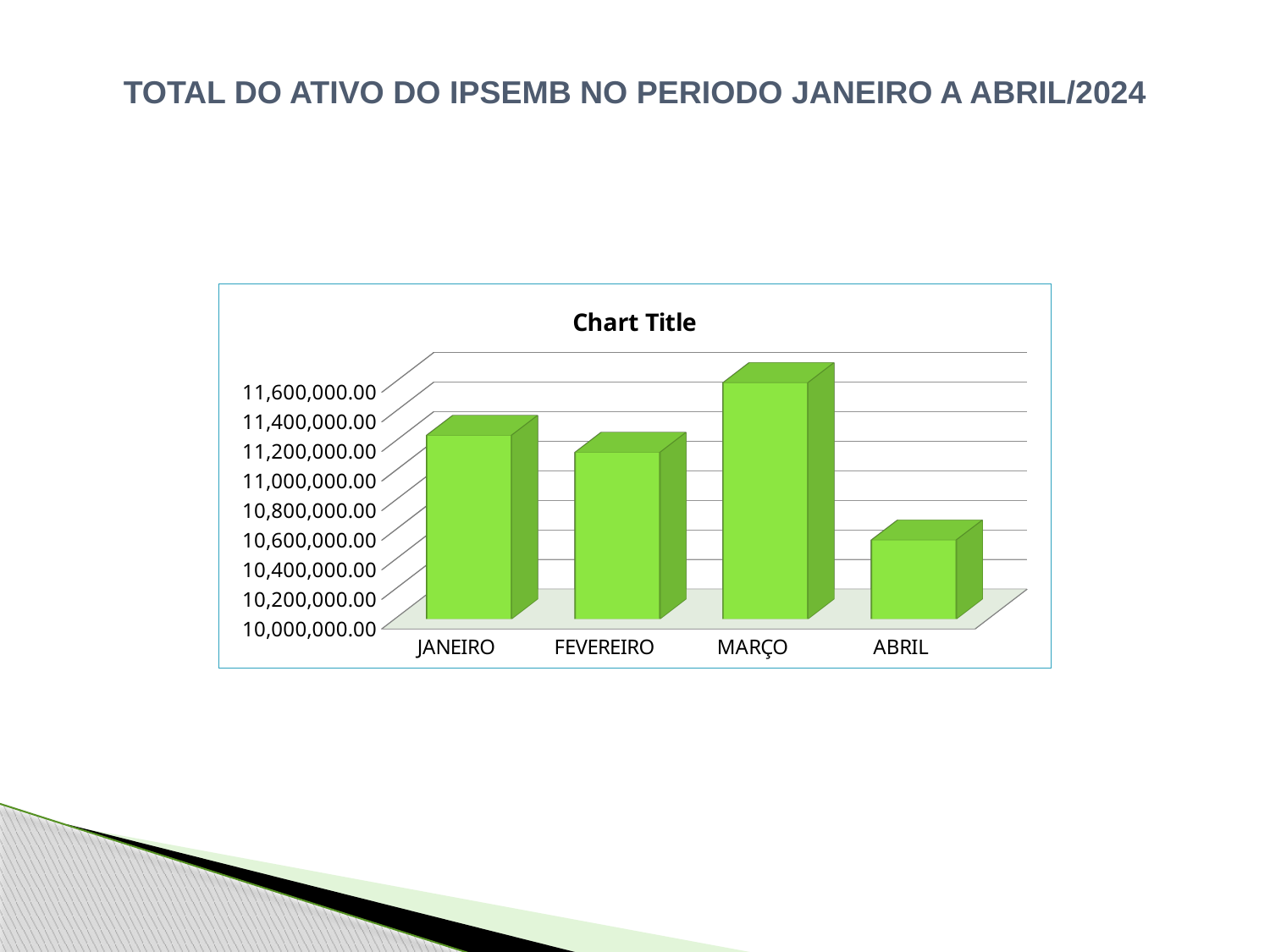
Which is larger, the value for JANEIRO or the value for ABRIL? JANEIRO Does the value rise or fall from MARÇO to ABRIL? fall Is the value for FEVEREIRO greater or less than 10,800,000.00? greater Which is larger, the value for MARÇO or the value for ABRIL? MARÇO Which month has the highest value in the chart? MARÇO What title is printed above the chart's plot area? Chart Title Which month has the lowest value in the chart? ABRIL Is the value for ABRIL greater or less than 11,000,000.00? less What kind of chart is shown on the slide? bar chart Is the value for MARÇO greater or less than 11,200,000.00? greater How many months are shown on the x axis of the chart? 4